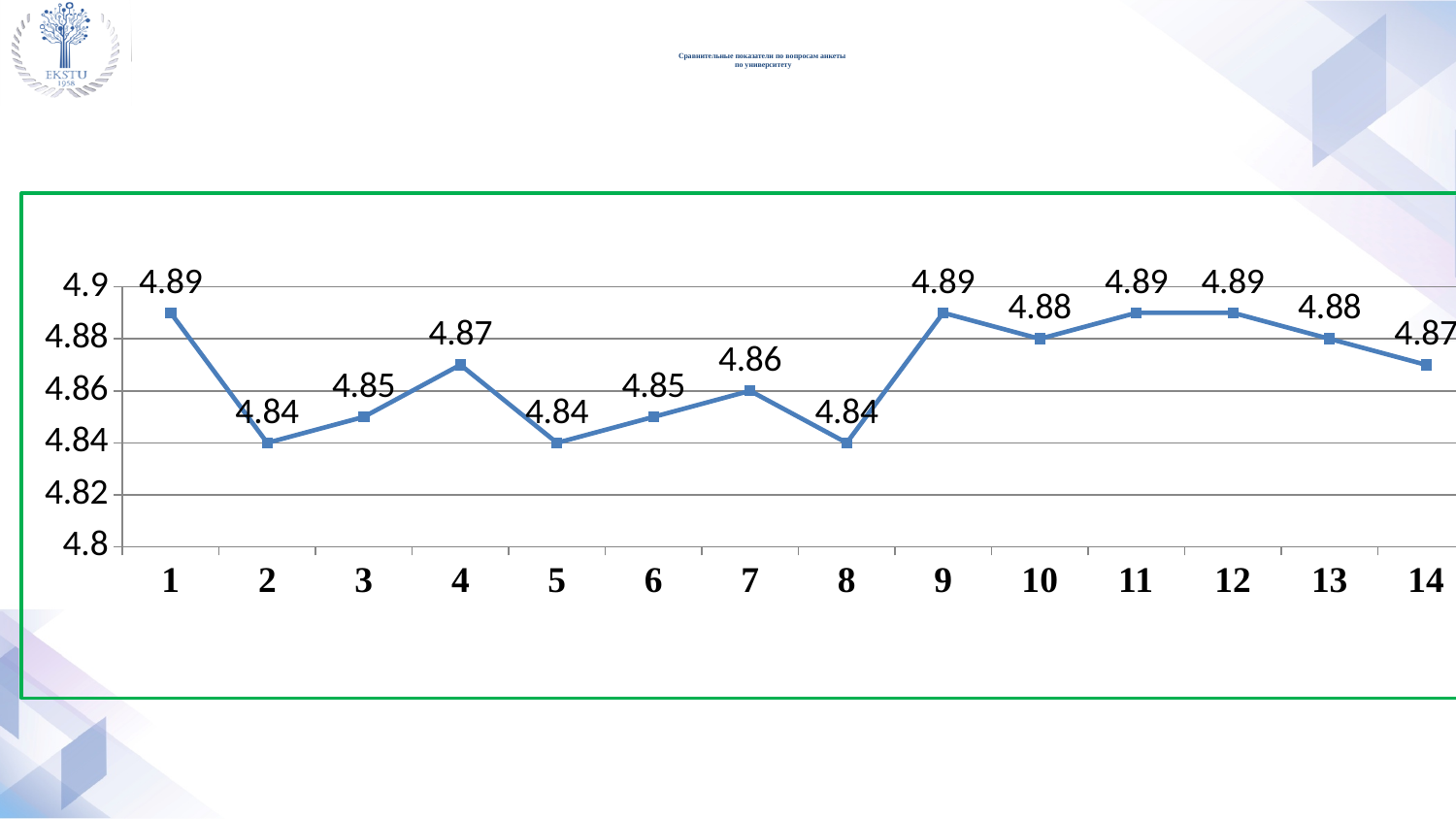
Which has the larger value, category 4 or category 5? Category 4 How many categories are shown on the x axis? 14 What is the value for category 7? 4.86 What kind of chart is shown on the slide? Line chart What is the value for category 1? 4.89 What is the lowest value plotted on the chart? 4.84 Is the value for category 9 greater or less than 4.86? greater Do the values rise or fall from category 12 to category 14? Fall What is the highest value plotted on the chart? 4.89 What is the value for category 14? 4.87 What is the value for category 10? 4.88 What is the difference between the values for category 1 and category 2? 0.05